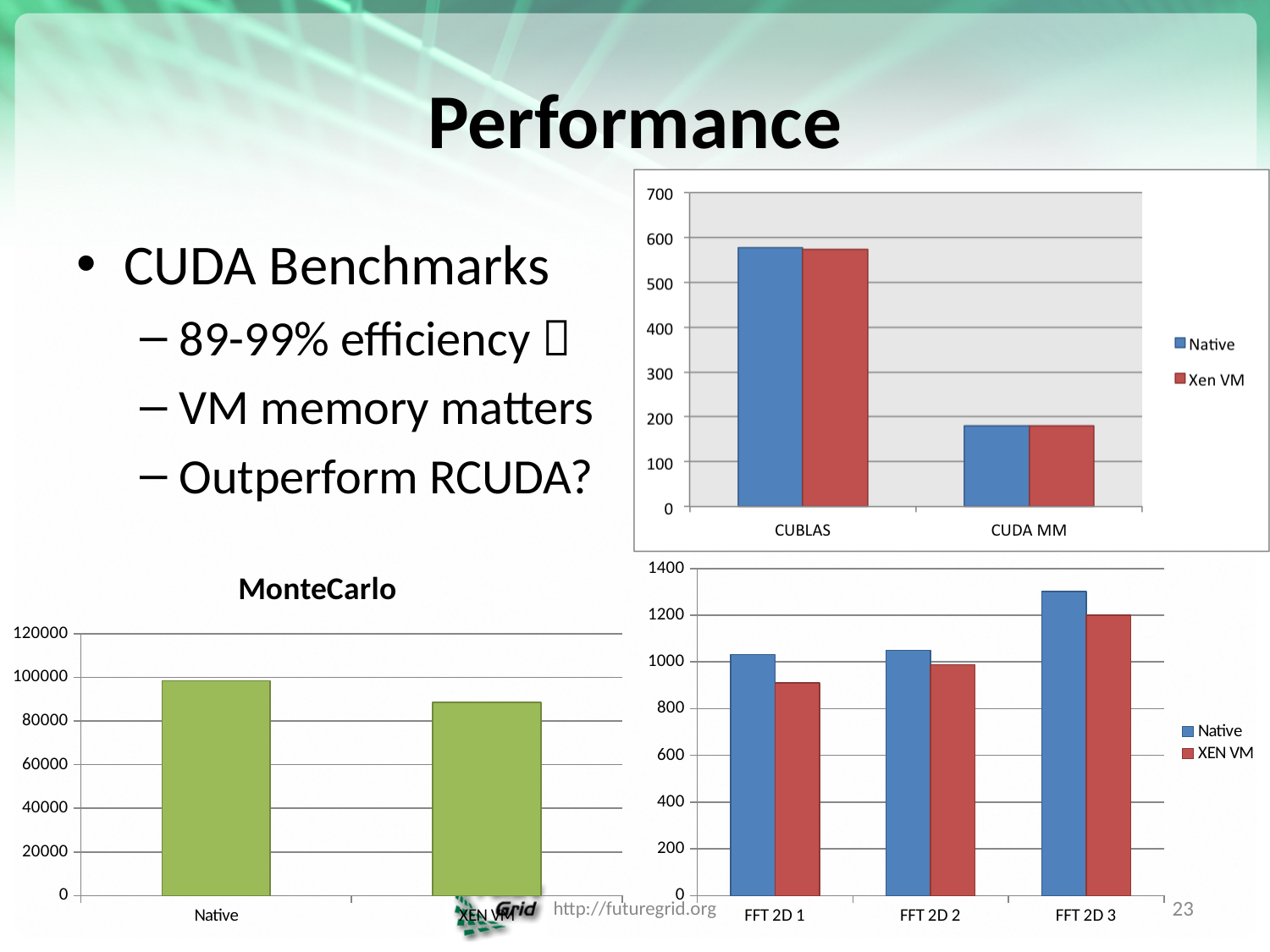
How many charts are shown on the slide? 3 In the MonteCarlo chart, which category has the higher value, Native or XEN VM? Native In the top-right chart, is the Xen VM value for CUDA MM greater or less than 300? less In the top-right chart, how many series does the legend list? 2 In the top-right chart, is the Native value for CUBLAS greater or less than 500? greater In the bottom-right chart, is the XEN VM value for FFT 2D 1 greater or less than 1000? less In the top-right chart, which category has the higher bars, CUBLAS or CUDA MM? CUBLAS In the bottom-right chart, which category has the highest Native value? FFT 2D 3 What is the title of the bottom-left chart? MonteCarlo In the bottom-right chart, how many categories are shown on the x axis? 3